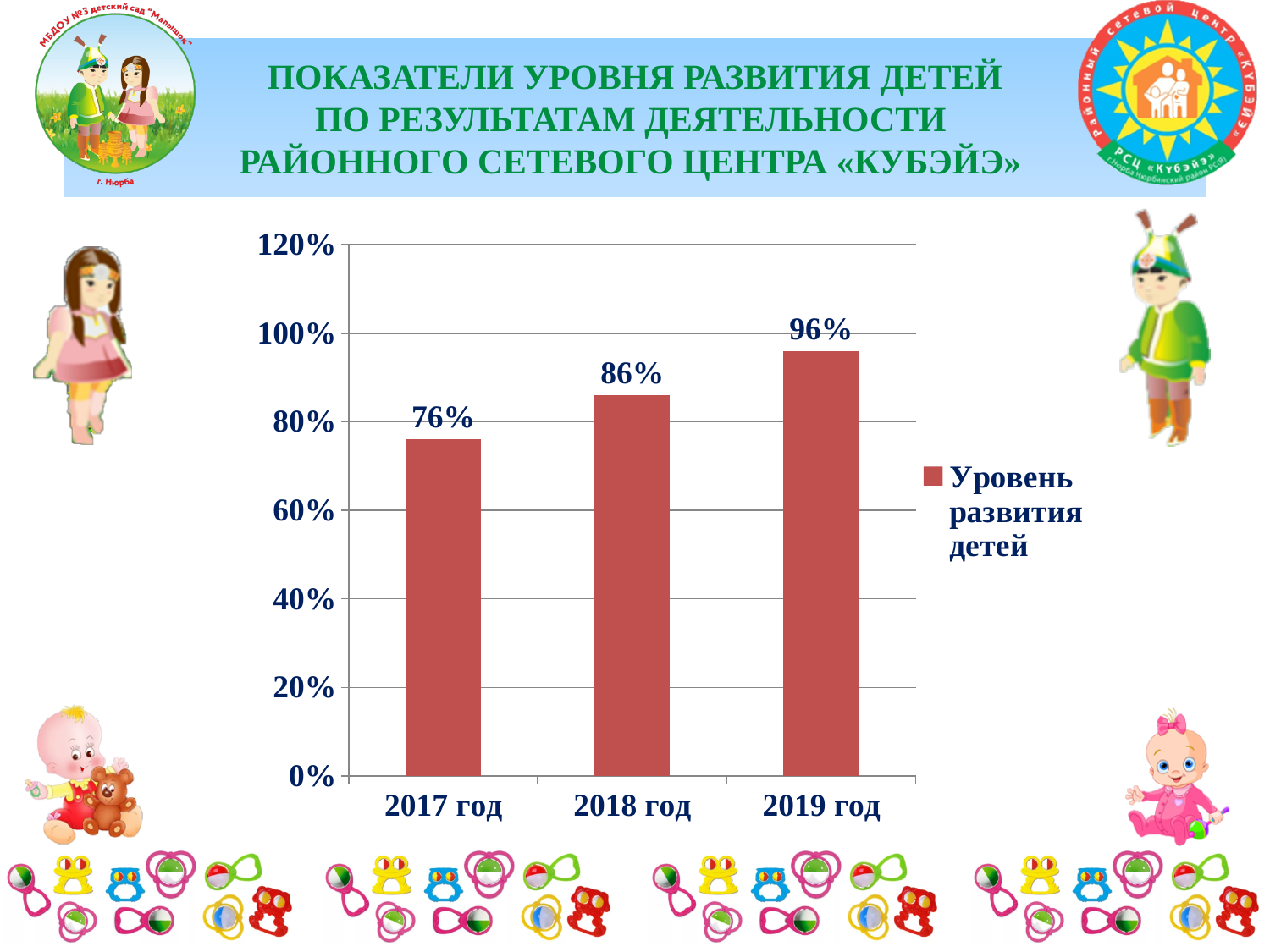
What is the value for 2018 год? 86% What is the difference between the values for 2019 год and 2017 год? 20% Which is larger, the value for 2018 год or the value for 2019 год? 2019 год What is the difference between the values for 2018 год and 2017 год? 10% Which year has the highest value? 2019 год How many series does the legend list? 1 How many years are shown on the x axis? 3 Is the value for 2017 год greater or less than 80%? less What kind of chart is shown on the slide? bar chart What is the value for 2019 год? 96% Which year has the lowest value? 2017 год What is the value for 2017 год? 76%